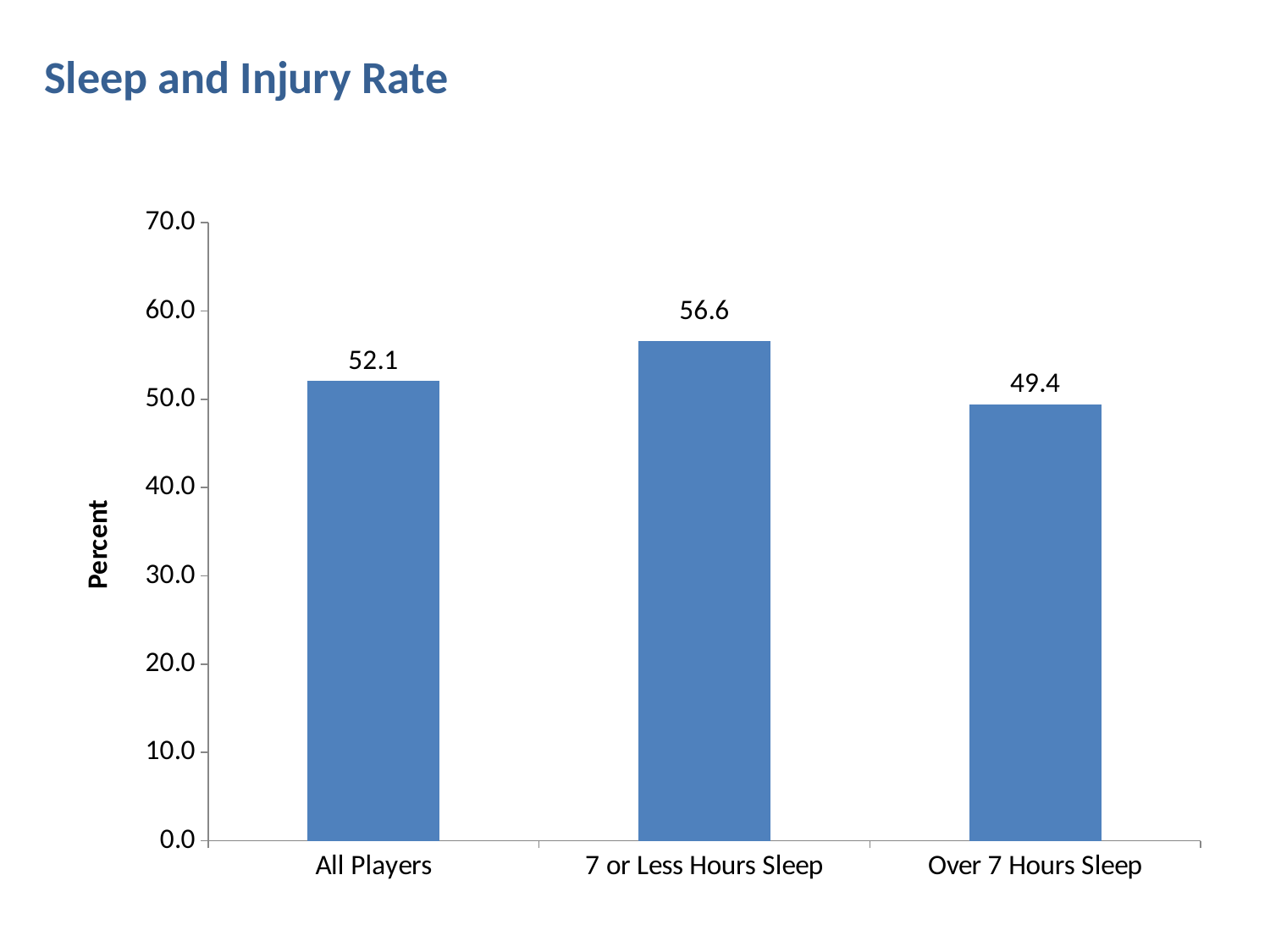
How many categories are shown on the chart? 3 What is the label of the vertical axis? Percent What is the difference between the values for 7 or Less Hours Sleep and All Players? 4.5 Which is larger, the value for All Players or the value for Over 7 Hours Sleep? All Players Is the value for Over 7 Hours Sleep greater or less than 50.0? less What is the value for 7 or Less Hours Sleep? 56.6 What kind of chart is shown on the slide? bar chart Which category has the lowest value? Over 7 Hours Sleep What is the value for Over 7 Hours Sleep? 49.4 What is the value for All Players? 52.1 Which category has the highest value? 7 or Less Hours Sleep What is the difference between the values for 7 or Less Hours Sleep and Over 7 Hours Sleep? 7.2